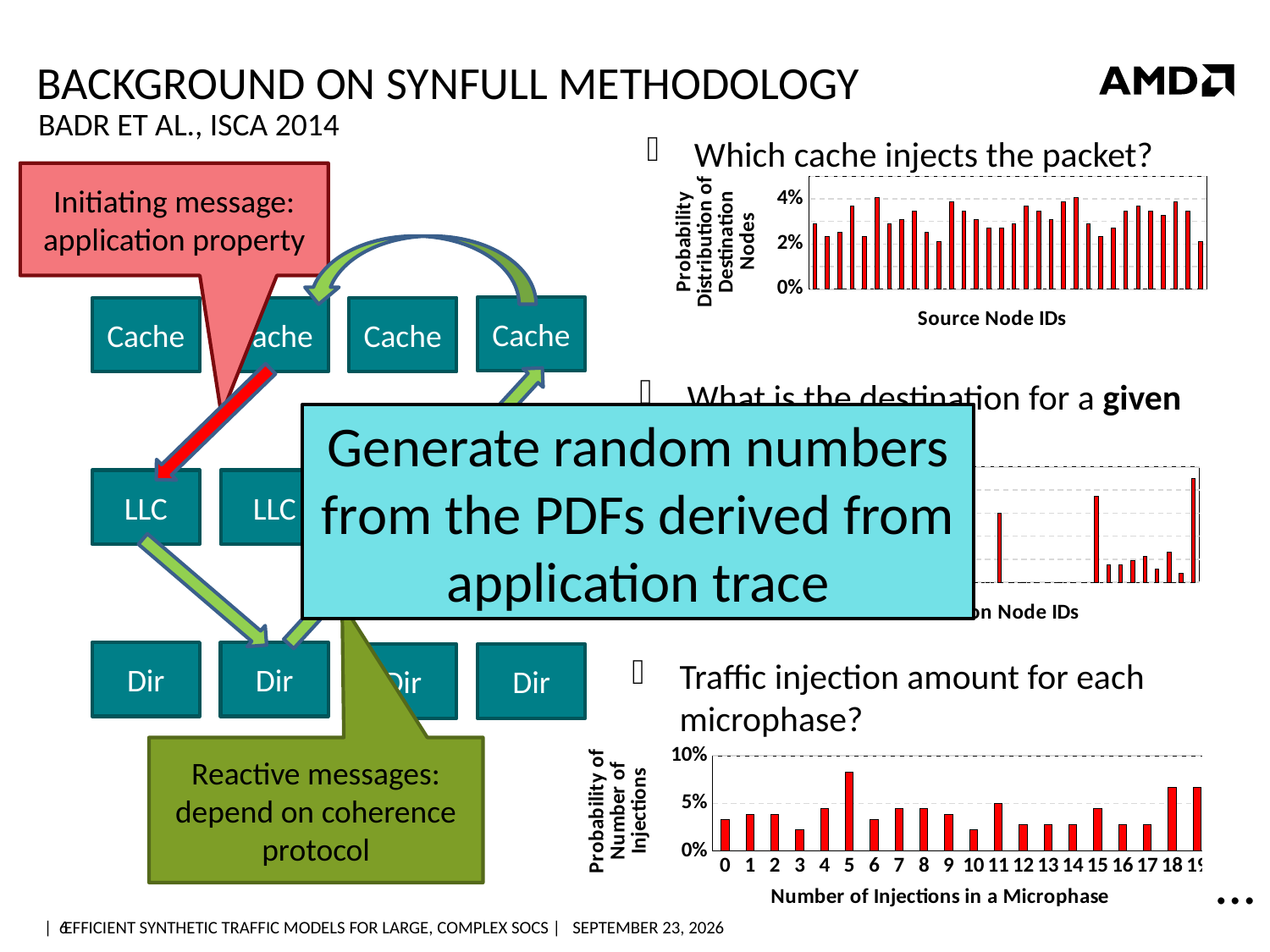
In the bottom-right chart (Number of Injections in a Microphase), is the value for 5 injections greater or less than 5%? greater In the bottom-right chart (Number of Injections in a Microphase), is the value for 3 injections greater or less than 5%? less How many categories are labelled on the x axis of the bottom-right chart (Number of Injections in a Microphase)? 20 In the bottom-right chart (Number of Injections in a Microphase), is the value for 0 injections greater or less than 5%? less In the bottom-right chart (Number of Injections in a Microphase), which is larger: the value for 5 injections or the value for 0 injections? 5 injections What type of chart is the bottom-right chart titled with the x-axis 'Number of Injections in a Microphase'? bar chart In the bottom-right chart (Number of Injections in a Microphase), which number of injections has the highest probability? 5 What type of chart is the top-right chart with the x-axis 'Source Node IDs'? bar chart What is the y-axis title of the bottom-right chart? Probability of Number of Injections What is the x-axis title of the top-right chart? Source Node IDs In the bottom-right chart (Number of Injections in a Microphase), which is larger: the value for 18 injections or the value for 3 injections? 18 injections